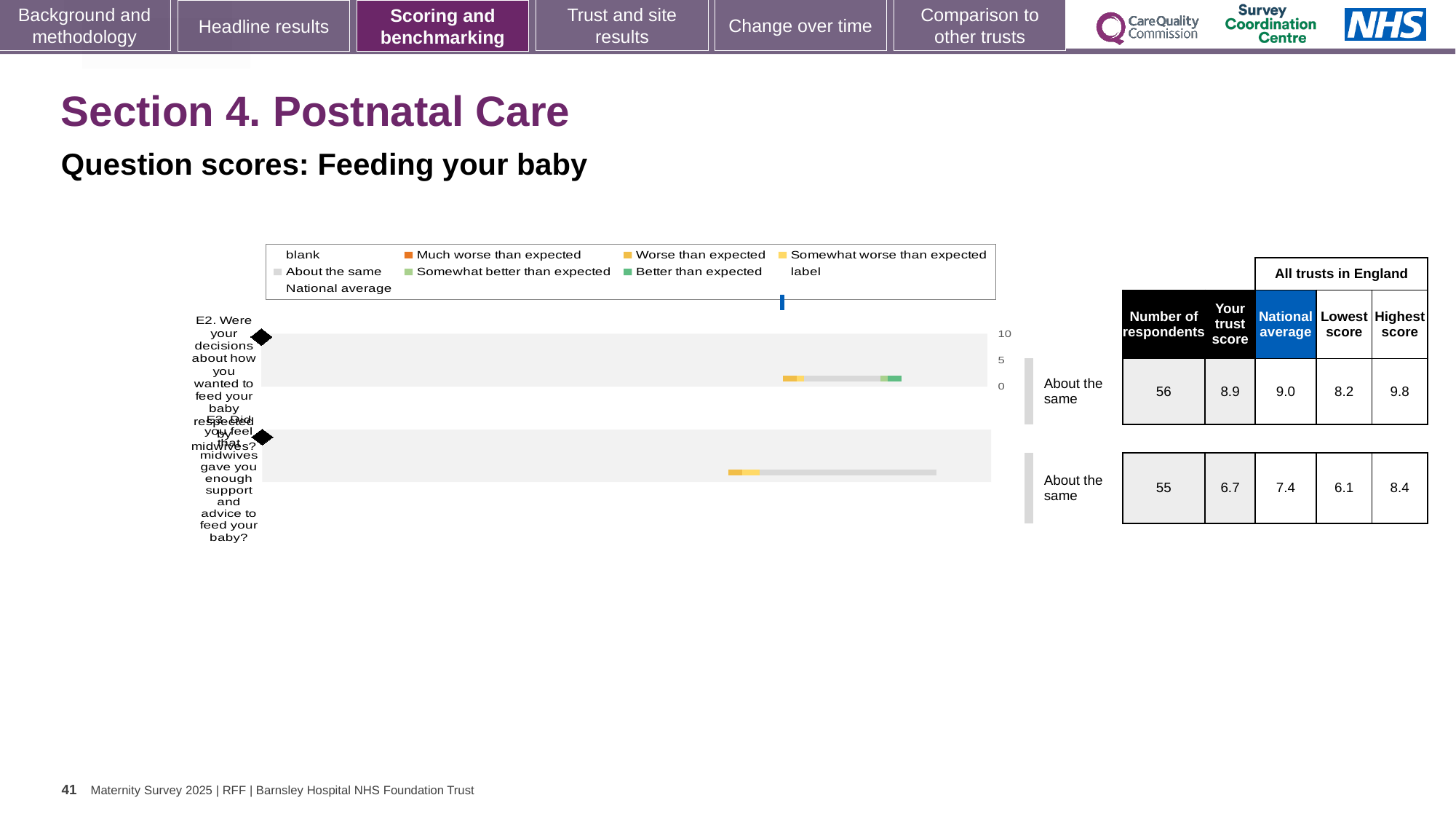
What is the trust score for question E3 (midwives gave enough support and advice to feed your baby)? 6.7 What kind of chart is shown on the slide? bar chart What is the difference between the national average and the trust score for question E3? 0.7 What is the national average for question E2? 9.0 What is the trust score for question E2 (decisions about how you wanted to feed your baby respected by midwives)? 8.9 Which question has the higher trust score, E2 or E3? E2 What is the national average for question E3? 7.4 How many questions (categories) are plotted on the chart? 2 What is the highest score among all trusts in England for question E2? 9.8 What is the lowest score among all trusts in England for question E3? 6.1 How many respondents answered question E3? 55 What benchmark category is shown for both questions E2 and E3? About the same